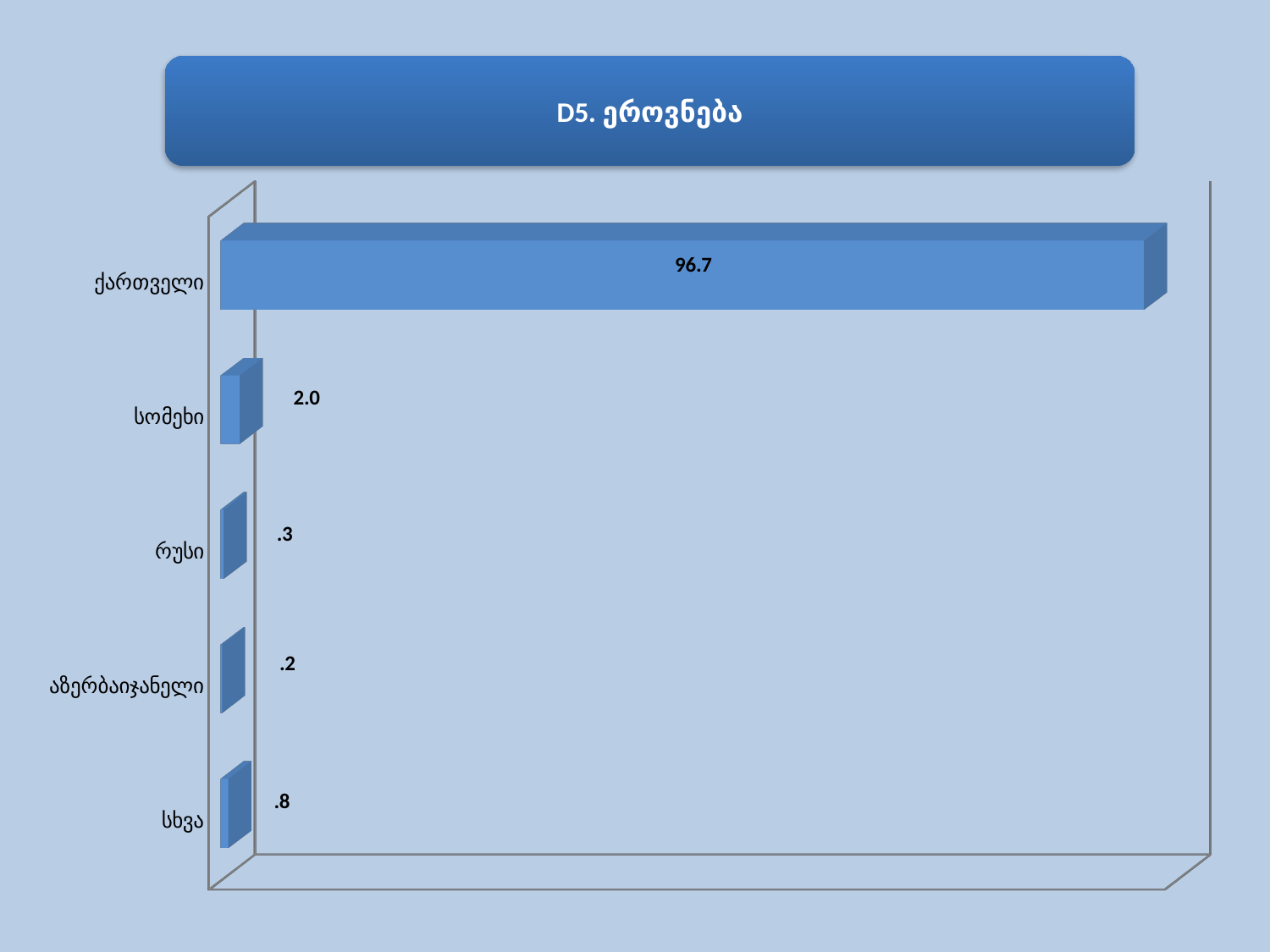
What is the value for რუსი? .3 Which category has the lowest value? აზერბაიჯანელი What kind of chart is shown on the slide? bar chart What is the value for სხვა? .8 What is the value for სომეხი? 2.0 What is the value for ქართველი? 96.7 What is the difference between the values for ქართველი and სომეხი? 94.7 Which category has the highest value? ქართველი What is the value for აზერბაიჯანელი? .2 What is the title of the chart? D5. ეროვნება Which is larger, the value for სხვა or the value for რუსი? სხვა How many categories are shown in the chart? 5